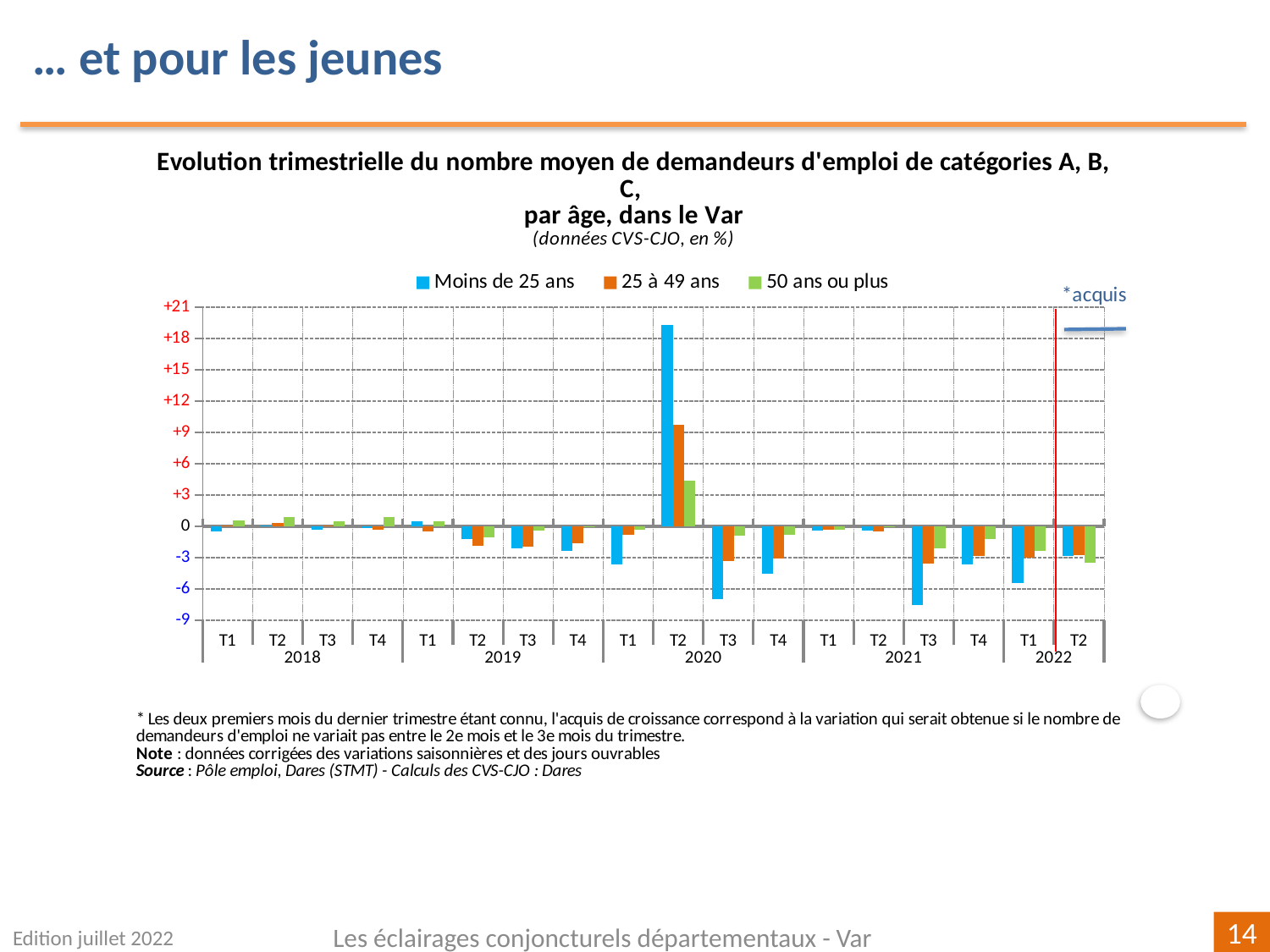
How many quarters are shown on the x axis? 18 How many series does the legend list? 3 Is the value for '25 à 49 ans' in T2 2020 greater or less than +6? greater What does the red vertical line before T2 2022 indicate? acquis What kind of chart is shown on the slide? bar chart In which quarter does the 'Moins de 25 ans' series reach its highest value? T2 2020 Is the value for 'Moins de 25 ans' in T3 2020 greater or less than -6? less Is the value for 'Moins de 25 ans' in T2 2020 greater or less than +18? greater Which series are listed in the legend? Moins de 25 ans, 25 à 49 ans, 50 ans ou plus In T2 2020, which series has the larger value: 'Moins de 25 ans' or '25 à 49 ans'? Moins de 25 ans